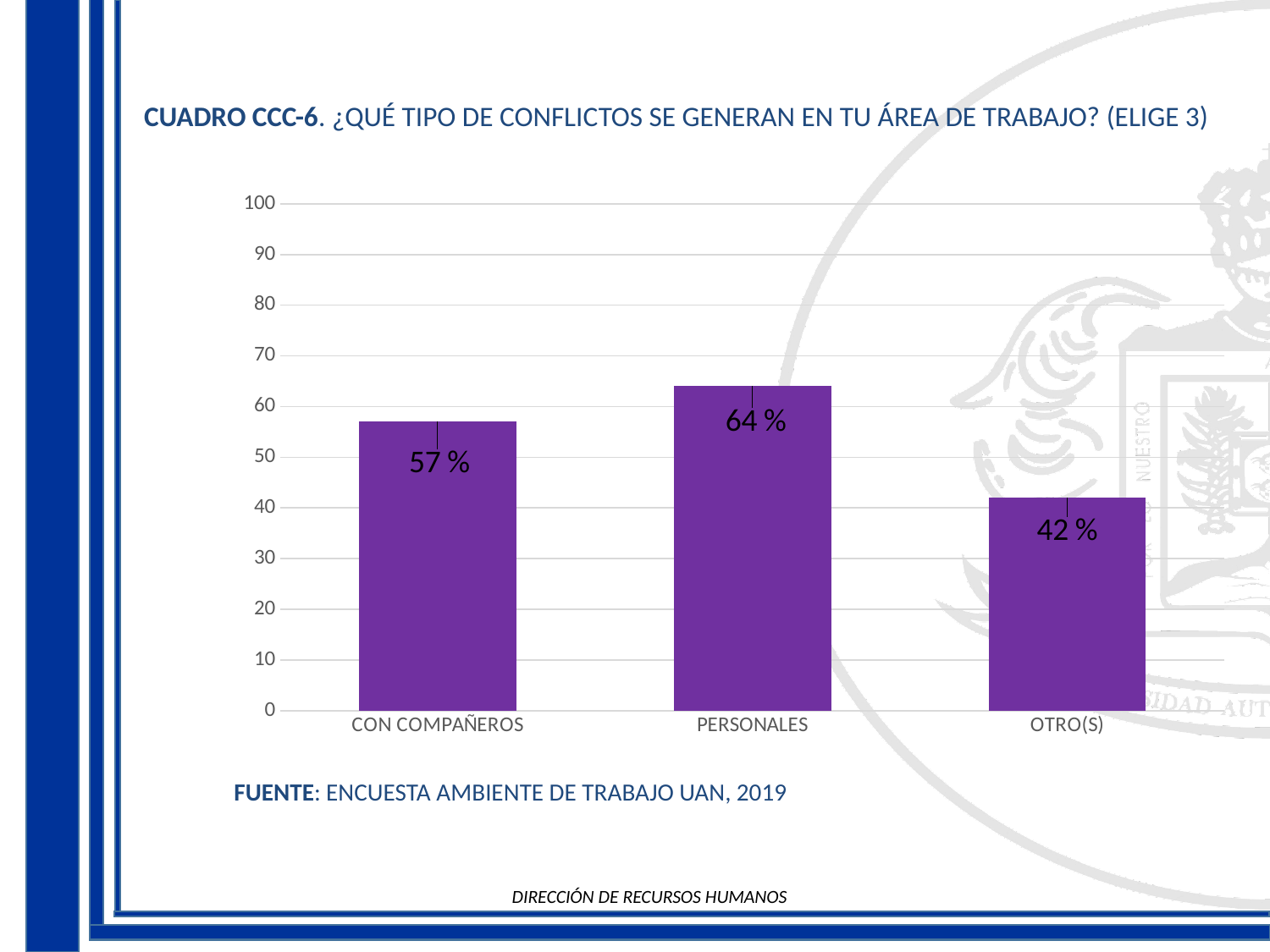
What is the value for OTRO(S)? 42 % Is the value for PERSONALES greater or less than 60? greater What is the difference between the values for CON COMPAÑEROS and OTRO(S)? 15 % How many categories are shown in the chart? 3 Which category has the highest value? PERSONALES Which is larger, the value for CON COMPAÑEROS or the value for OTRO(S)? CON COMPAÑEROS What kind of chart is shown on the slide? Bar chart What is the difference between the values for PERSONALES and CON COMPAÑEROS? 7 % What is the value for PERSONALES? 64 % Which category has the lowest value? OTRO(S) What is the value for CON COMPAÑEROS? 57 % What is the source cited below the chart? ENCUESTA AMBIENTE DE TRABAJO UAN, 2019